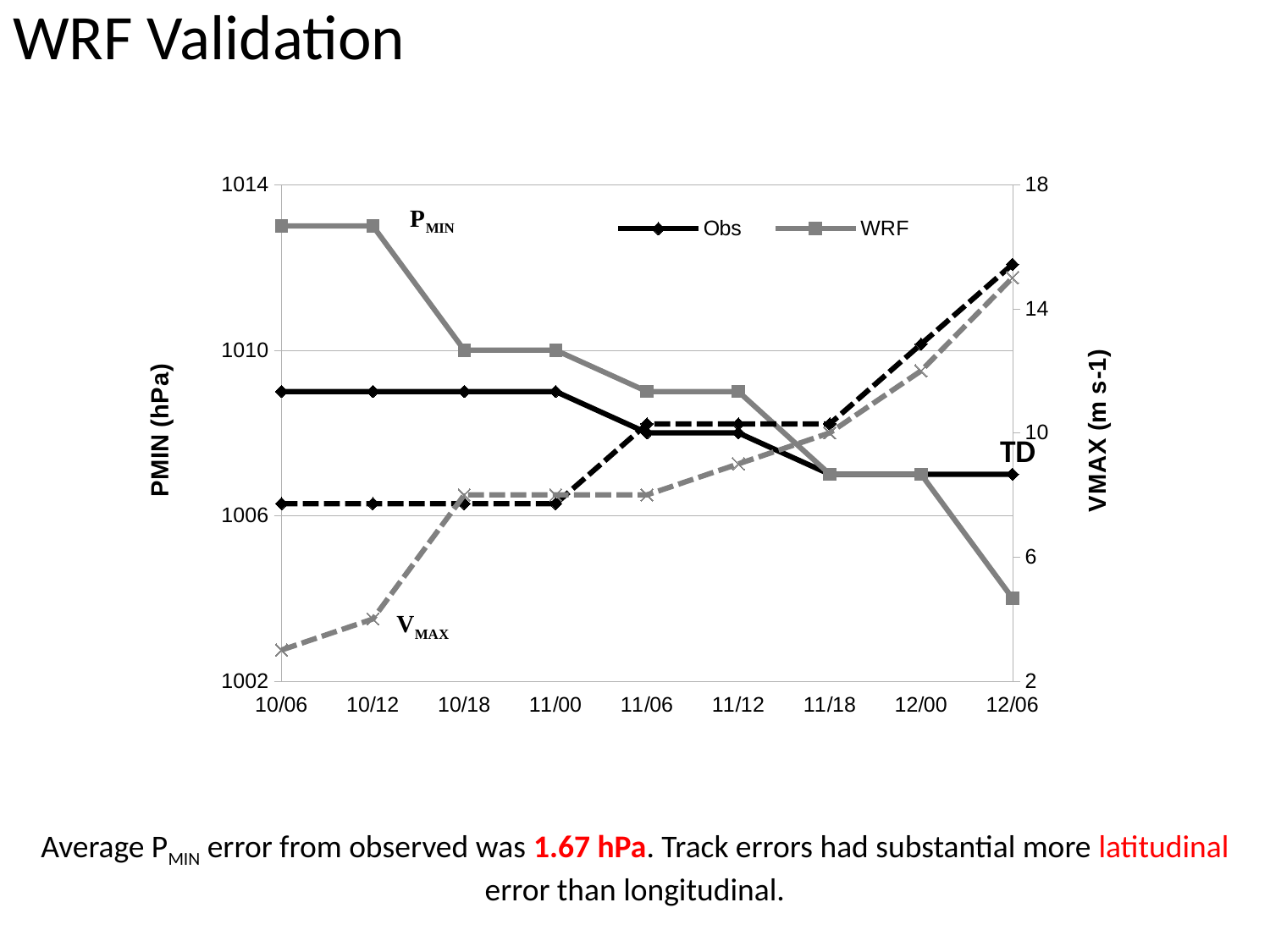
Is the WRF PMIN value at 12/06 greater or less than 1006? less How many series does the chart legend list? 2 What is the label of the left vertical axis? PMIN (hPa) At which time is the WRF PMIN value lowest? 12/06 Is the WRF PMIN value at 10/06 greater or less than 1010? greater How many time points are shown along the x axis? 9 What kind of chart is shown on the slide? line chart At which time is the Obs VMAX value highest? 12/06 What is the label of the right vertical axis? VMAX (m s-1) Is the WRF VMAX value at 10/06 greater or less than 6? less At 10/06, which is larger, the WRF PMIN value or the Obs PMIN value? WRF